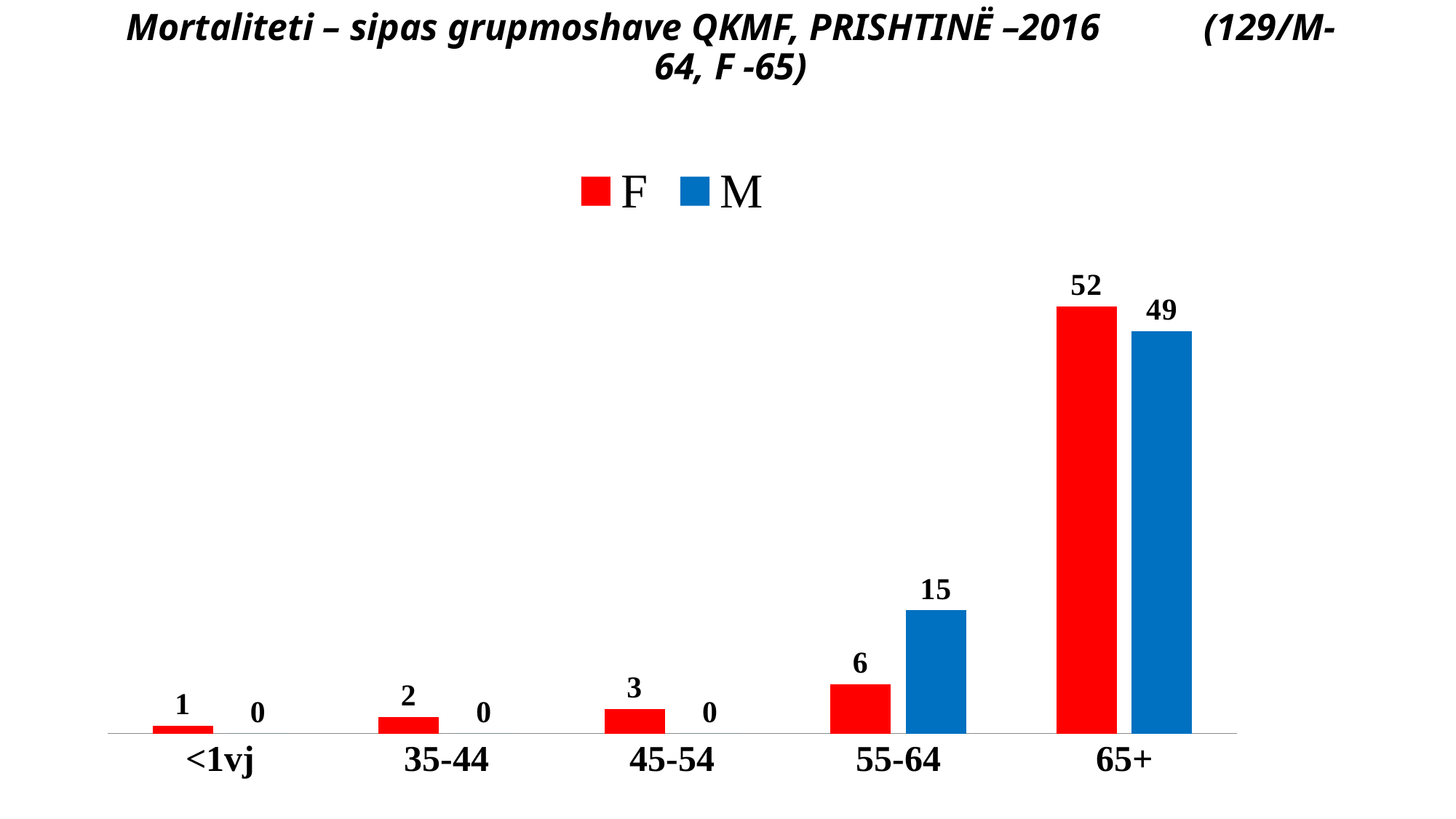
Which age group has the lowest value for F? <1vj What is the value for M in the 55-64 age group? 15 In the 55-64 age group, which series has the larger value, F or M? M Which age group has the highest value for M? 65+ What is the value for F in the 65+ age group? 52 What is the difference between F and M in the 65+ age group? 3 What kind of chart is shown on the slide? Bar chart How many series does the legend list? 2 What is the value for M in the 35-44 age group? 0 What is the value for F in the 45-54 age group? 3 What is the difference between M and F in the 55-64 age group? 9 How many age groups are shown on the x axis? 5